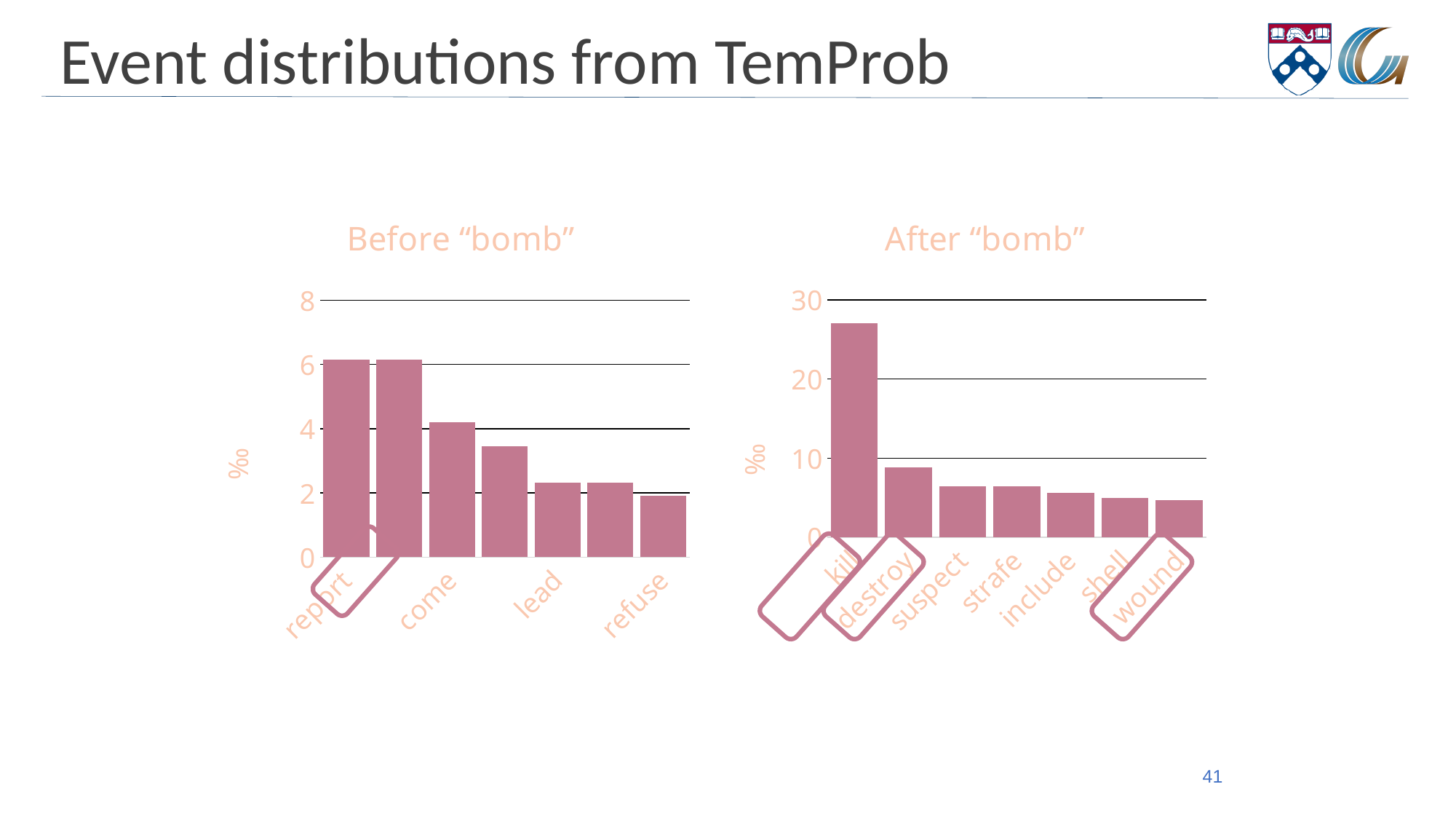
In the "After "bomb"" chart, is the value for kill greater or less than 20? greater What kind of chart is the "Before "bomb"" chart? bar chart In the "After "bomb"" chart, which is larger, the value for destroy or the value for wound? destroy What unit is shown on the y axis of the "After "bomb"" chart? ‰ How many bars does the "After "bomb"" chart show? 7 How many bars does the "Before "bomb"" chart show? 7 In the "After "bomb"" chart, which event has the highest value? kill In the "Before "bomb"" chart, which labelled event has the lowest value? refuse In the "Before "bomb"" chart, is the value for report greater or less than 4? greater In the "Before "bomb"" chart, is the value for lead greater or less than 4? less In the "After "bomb"" chart, do the values rise or fall from left to right? fall